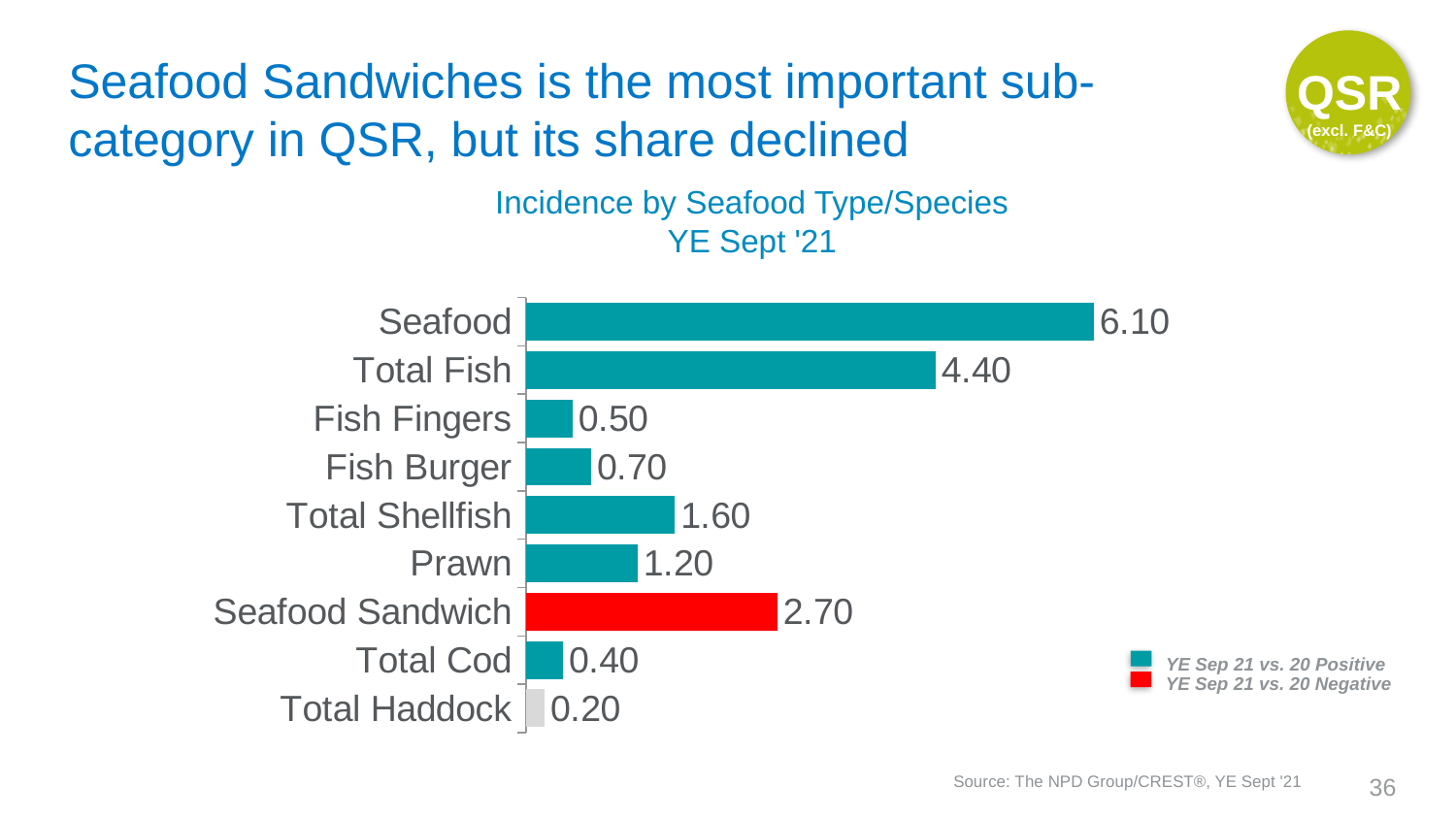
How many categories are shown in the chart? 9 What is the difference between the values for Total Shellfish and Prawn? 0.40 What is the difference between the values for Seafood and Total Fish? 1.70 Which is larger, the value for Fish Burger or the value for Fish Fingers? Fish Burger Which category is shown with a red bar, indicating a negative change YE Sep 21 vs. 20? Seafood Sandwich Which category has the highest value? Seafood What is the value for Seafood Sandwich? 2.70 Which is larger, the value for Seafood Sandwich or the value for Total Shellfish? Seafood Sandwich What is the value for Fish Burger? 0.70 What is the value for Total Shellfish? 1.60 What kind of chart is shown on the slide? Bar chart Which category has the lowest value? Total Haddock